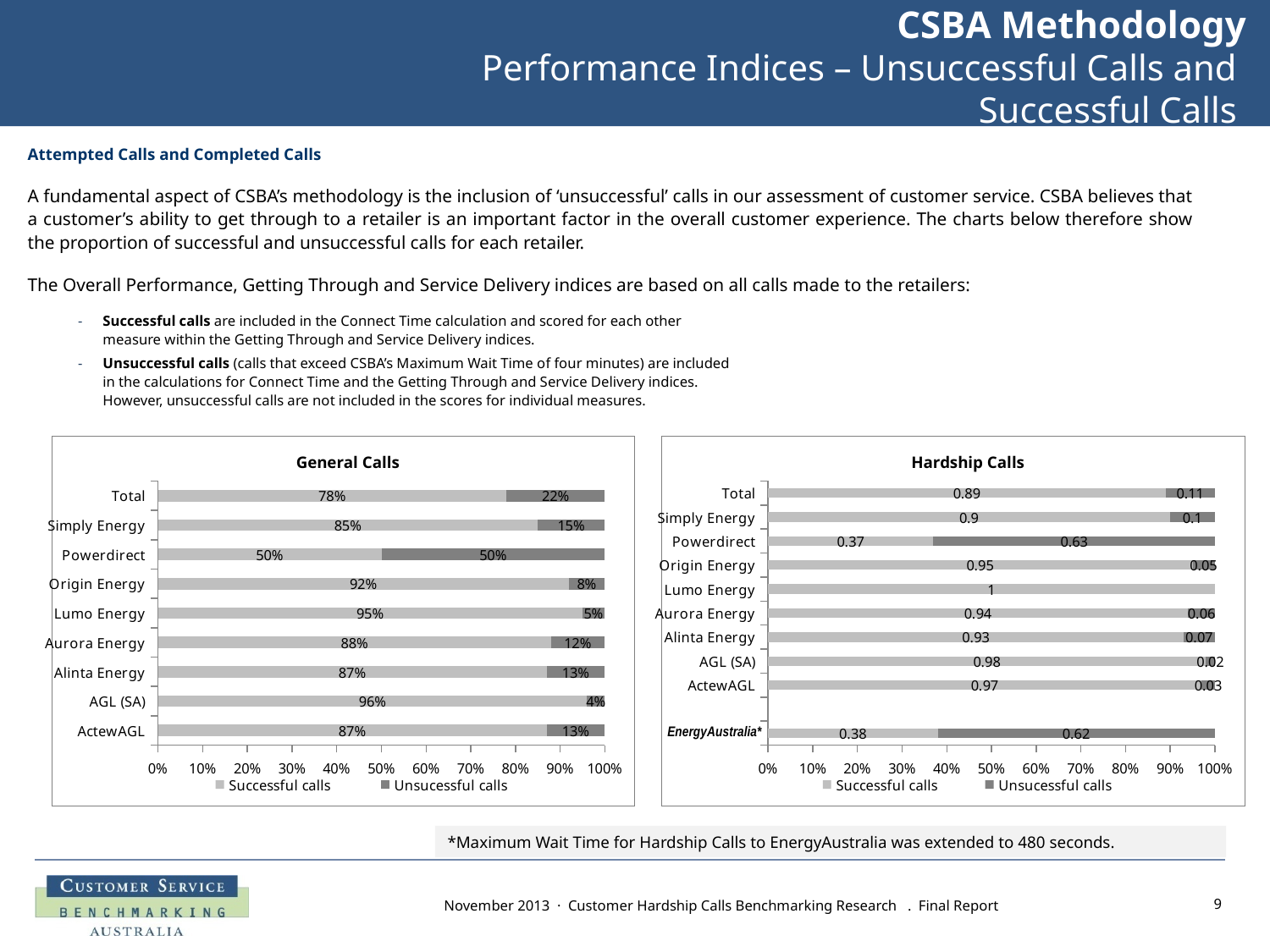
In the General Calls chart, how many categories are shown on the vertical axis? 9 How many series does the legend of the Hardship Calls chart list? 2 In the General Calls chart, which retailer has the highest proportion of successful calls? AGL (SA) In the General Calls chart, what percentage of calls to Powerdirect were unsuccessful? 50% In the Hardship Calls chart, which is larger: the successful calls value for Powerdirect or for EnergyAustralia*? EnergyAustralia* What type of chart is the General Calls chart? Stacked bar chart In the General Calls chart, what is the difference between the successful call percentages for Lumo Energy and Aurora Energy? 7% In the Hardship Calls chart, what is the unsuccessful calls value for EnergyAustralia*? 0.62 In the Hardship Calls chart, which retailer has the highest successful calls value? Lumo Energy In the General Calls chart, what percentage of calls to AGL (SA) were successful? 96% In the Hardship Calls chart, what is the successful calls value for Alinta Energy? 0.93 In the General Calls chart, which retailer has the lowest proportion of successful calls? Powerdirect